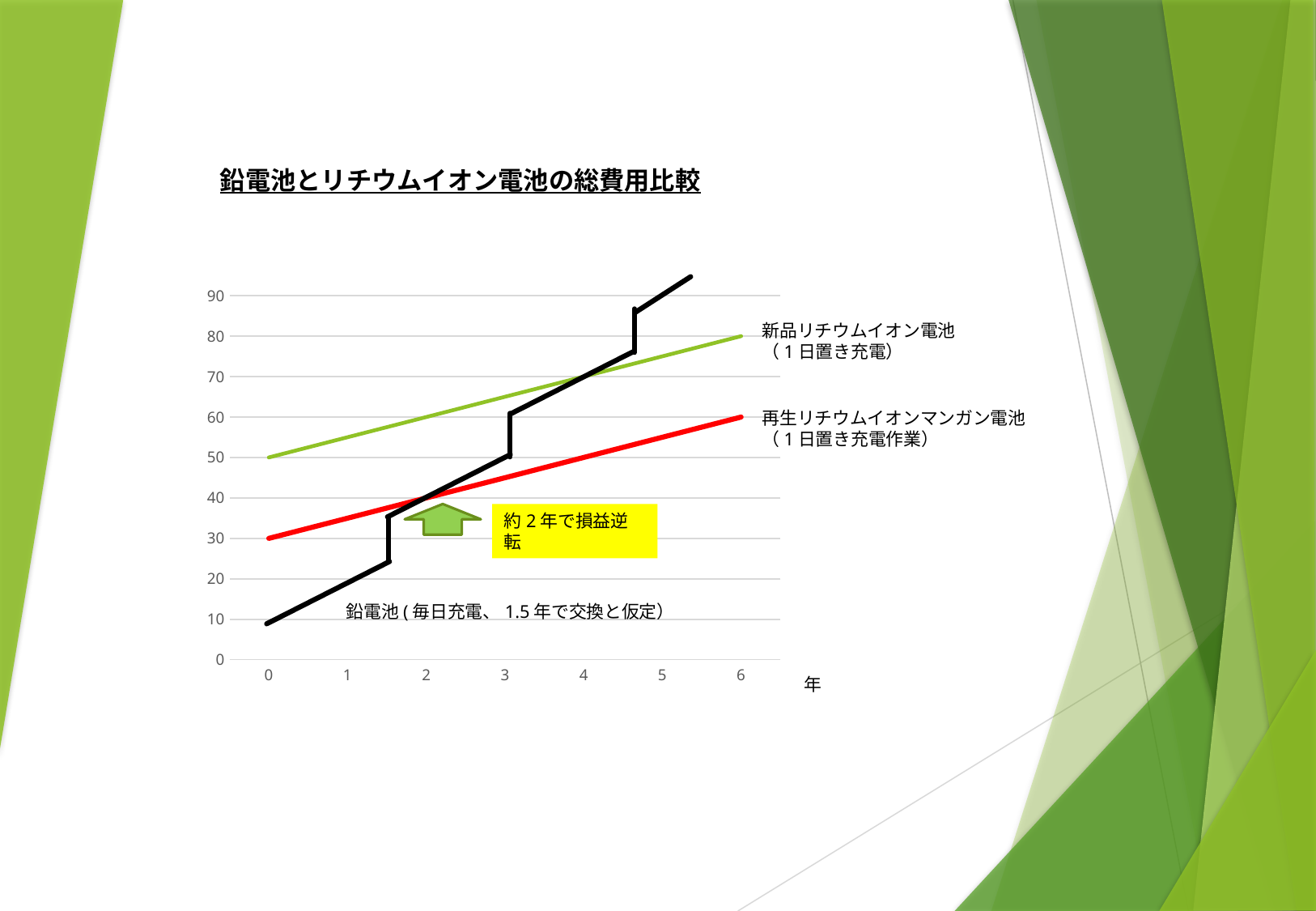
What is the value of the 再生リチウムイオンマンガン電池 line at year 6? 60 How many lines are plotted on the chart? 3 What type of chart is shown on the slide? line chart Do the values of the 再生リチウムイオンマンガン電池 line rise or fall as the years increase? rise What is the value of the 新品リチウムイオン電池 line at year 0? 50 What is the title of the chart? 鉛電池とリチウムイオン電池の総費用比較 What does the yellow annotation box on the chart say? 約2年で損益逆転 What is the value of the 再生リチウムイオンマンガン電池 line at year 0? 30 What is the value of the 新品リチウムイオン電池 line at year 6? 80 At year 5, which line is higher: 鉛電池 or 新品リチウムイオン電池? 鉛電池 What is the difference between the 新品リチウムイオン電池 and 再生リチウムイオンマンガン電池 values at year 0? 20